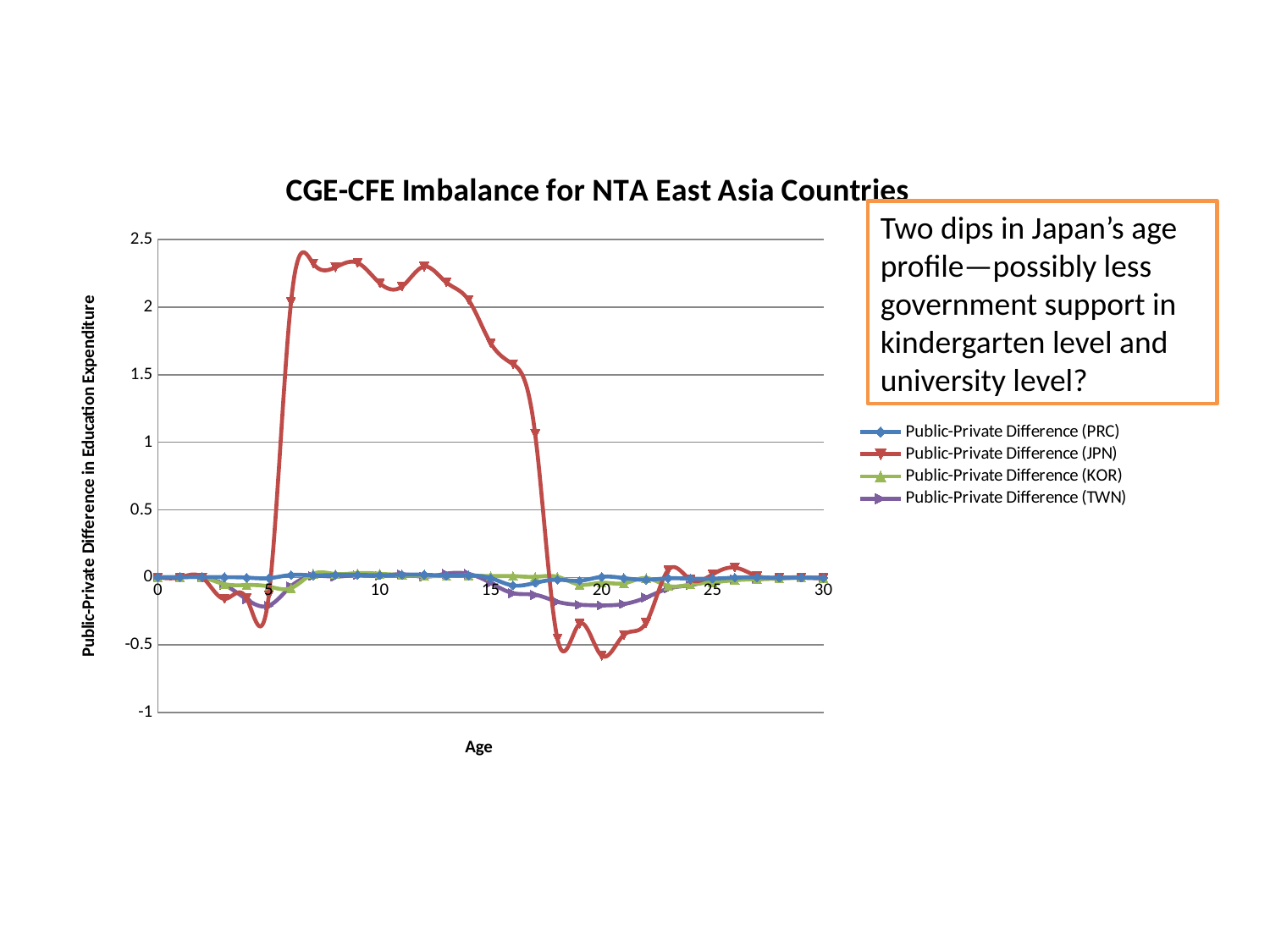
Which series reaches the lowest value on the chart? Public-Private Difference (JPN) Is the value for Public-Private Difference (JPN) at age 10 greater or less than 2? greater How many series does the legend list? 4 What kind of chart is shown on the slide? line chart Which series reaches the highest value on the chart? Public-Private Difference (JPN) Is the value for Public-Private Difference (JPN) at age 15 greater or less than 1.5? greater Is the value for Public-Private Difference (TWN) at age 5 greater or less than 0? less What is the label of the x axis? Age Between age 15 and age 20, does the Public-Private Difference (JPN) line rise or fall? fall At age 10, which is larger: Public-Private Difference (JPN) or Public-Private Difference (PRC)? Public-Private Difference (JPN) What is the title of the chart? CGE-CFE Imbalance for NTA East Asia Countries